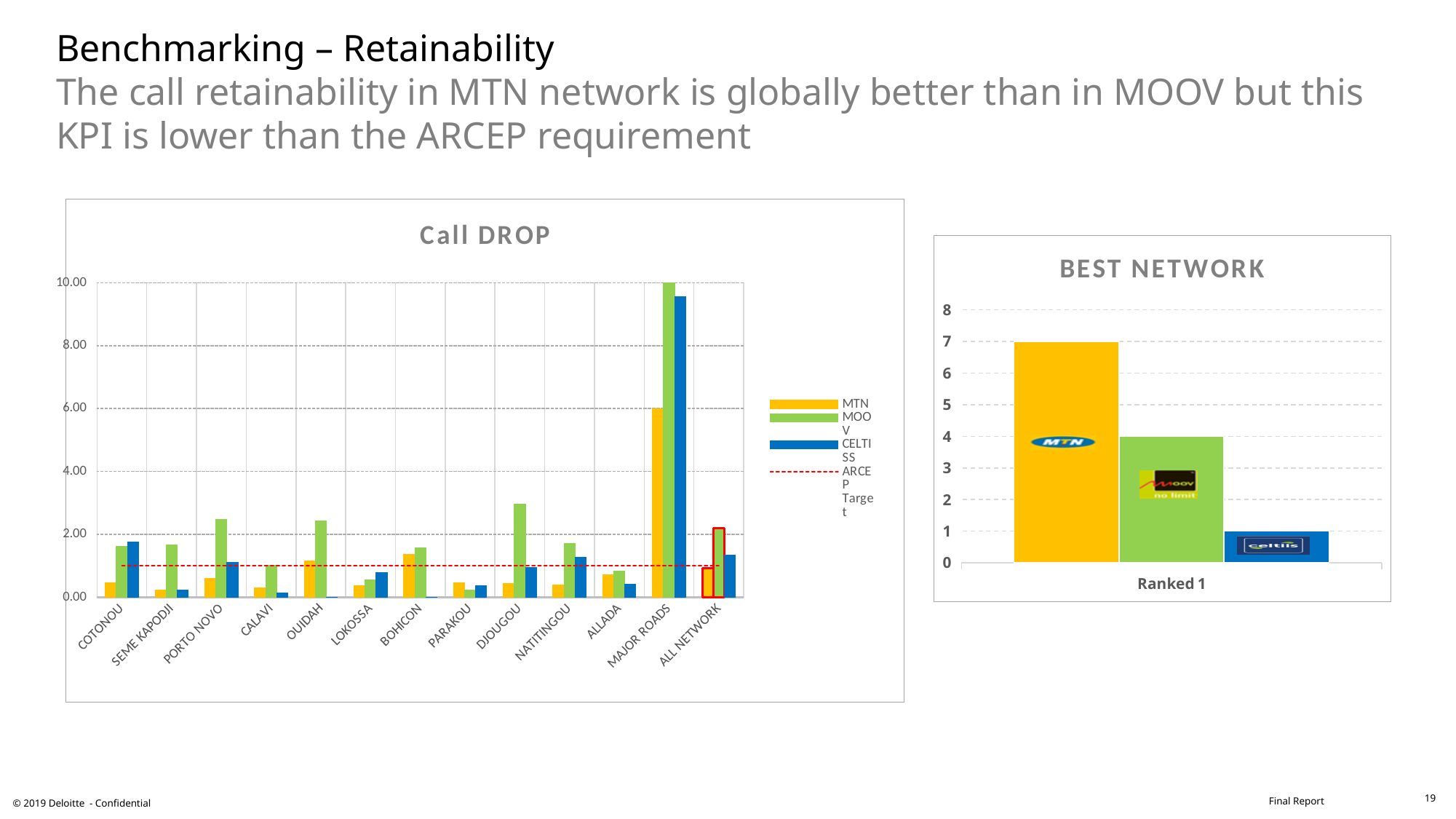
In the "Call DROP" chart, is the MTN value for COTONOU greater or less than 2.00? less In the "Call DROP" chart, what does the red dashed line represent according to the legend? ARCEP Target In the "Call DROP" chart, is the MOOV value for MAJOR ROADS greater or less than 8.00? greater In the "BEST NETWORK" chart, what is the difference between the MTN bar and the CELTISS bar? 6 What kind of chart is the "Call DROP" chart? combination bar and line chart How many categories are shown on the x axis of the "Call DROP" chart? 13 How many entries does the legend of the "Call DROP" chart list? 4 In the "Call DROP" chart, is the MOOV value for DJOUGOU greater or less than 2.00? greater In the "BEST NETWORK" chart, what is the value of the MTN bar? 7 In the "Call DROP" chart, which category has the highest MOOV value? MAJOR ROADS In the "BEST NETWORK" chart, what is the value of the MOOV bar? 4 In the "Call DROP" chart, which is larger at COTONOU: the MTN value or the MOOV value? MOOV